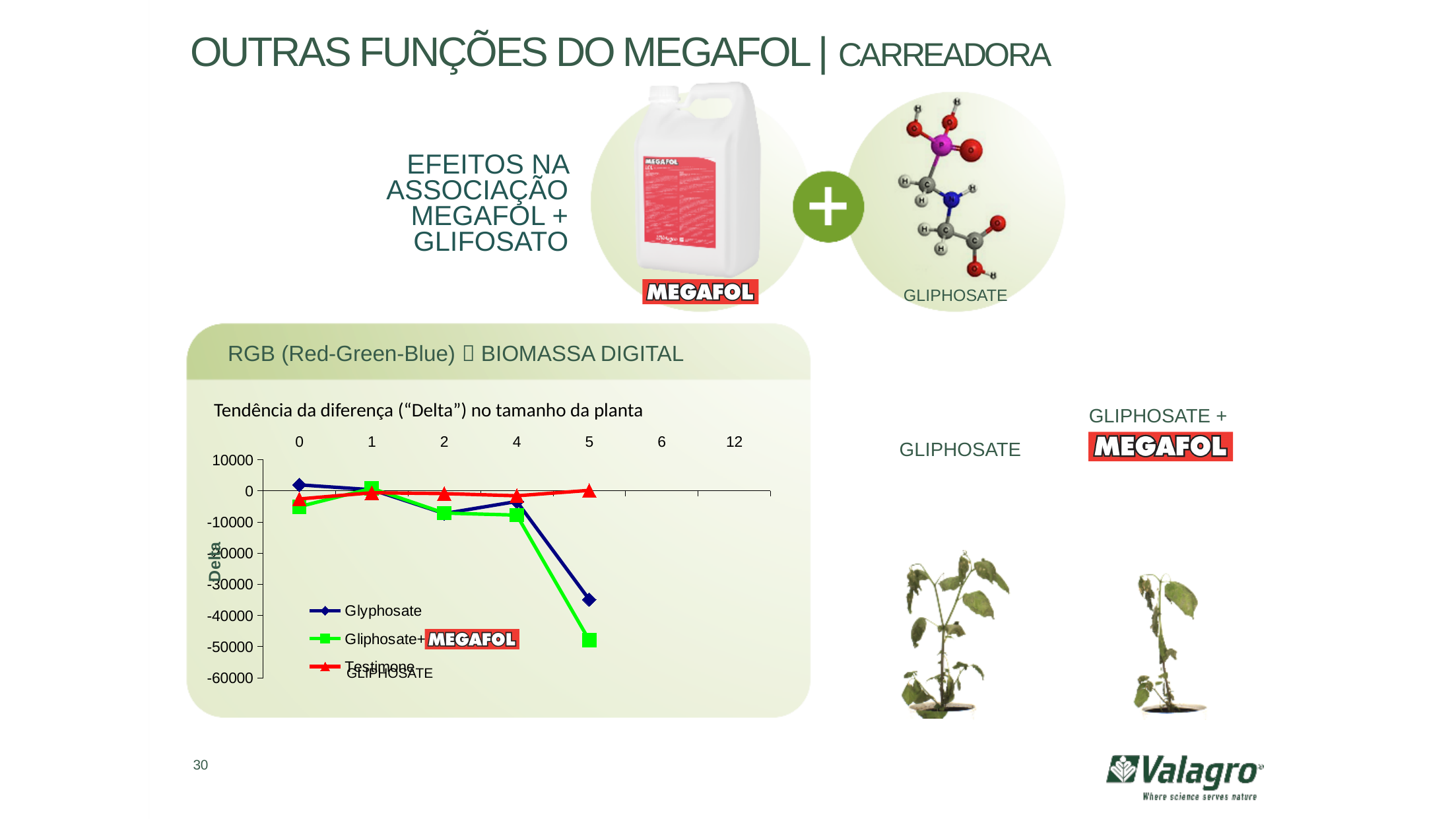
How many series does the chart legend list? 3 Is the value for Gliphosate+MEGAFOL at x = 5 greater or less than -40000? less At x = 5, which series has the larger value: Glyphosate or Gliphosate+MEGAFOL? Glyphosate At x = 5, which series has the larger value: Testimone or Glyphosate? Testimone Is the value for Gliphosate+MEGAFOL at x = 2 greater or less than 0? less What kind of chart is shown on the slide? line chart Is the value for Glyphosate at x = 5 greater or less than -40000? greater Which colour is used for the Testimone series in the chart? red How many category labels are shown along the x axis of the chart? 7 Does the Gliphosate+MEGAFOL series rise or fall overall from x = 1 to x = 5? fall What is the title of the chart? Tendência da diferença ("Delta") no tamanho da planta